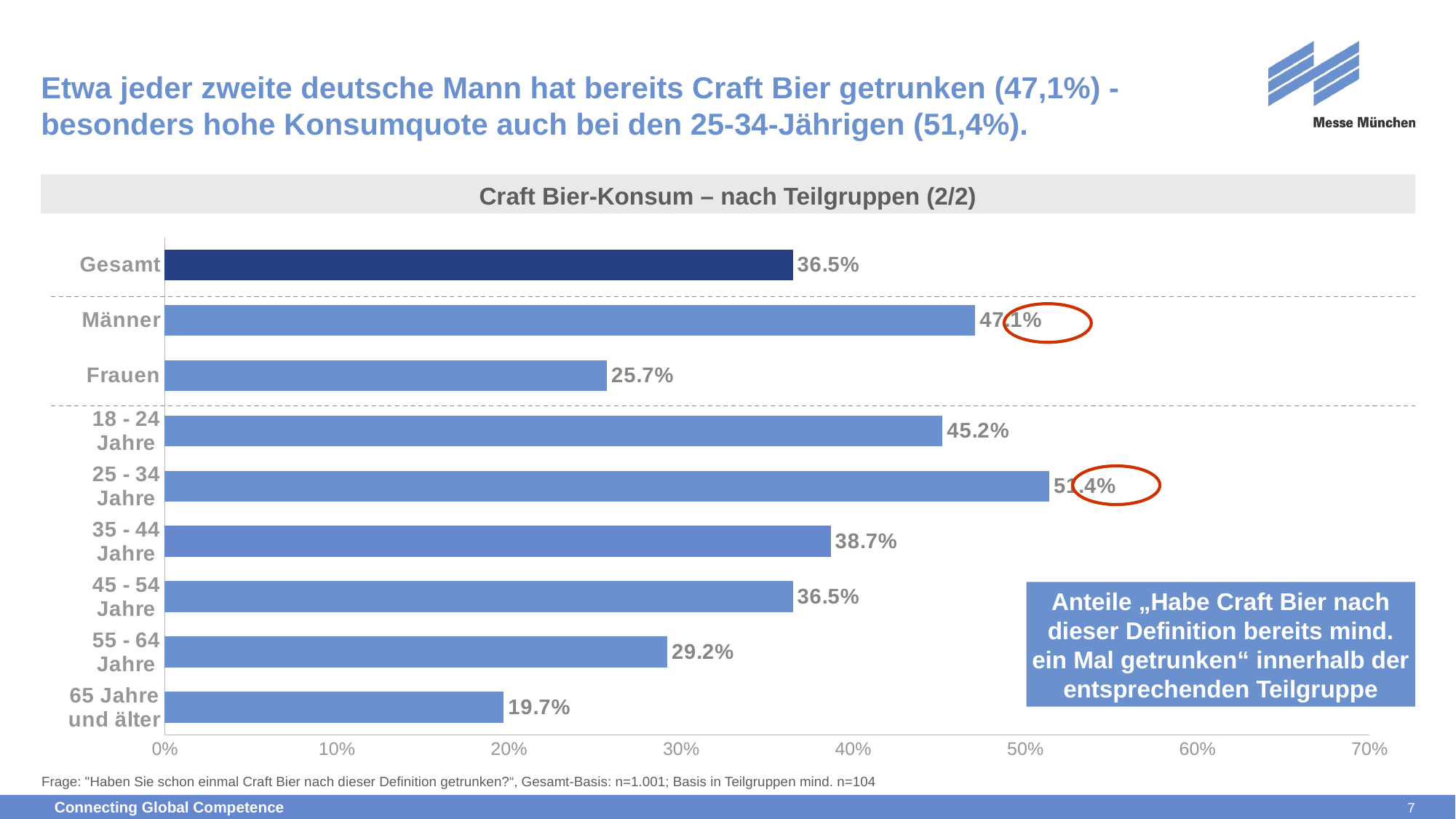
What is the value for Gesamt? 36.5% Is the value for 45 - 54 Jahre greater or less than 40%? less What is the value for 65 Jahre und älter? 19.7% What is the value for Frauen? 25.7% Which is larger, the value for 35 - 44 Jahre or the value for 55 - 64 Jahre? 35 - 44 Jahre What is the title of the chart? Craft Bier-Konsum – nach Teilgruppen (2/2) Which category has the highest value? 25 - 34 Jahre Which category has the lowest value? 65 Jahre und älter What kind of chart is shown on the slide? bar chart What is the difference between the values for Männer and Frauen? 21.4% How many categories are shown in the chart? 9 What is the value for 18 - 24 Jahre? 45.2%